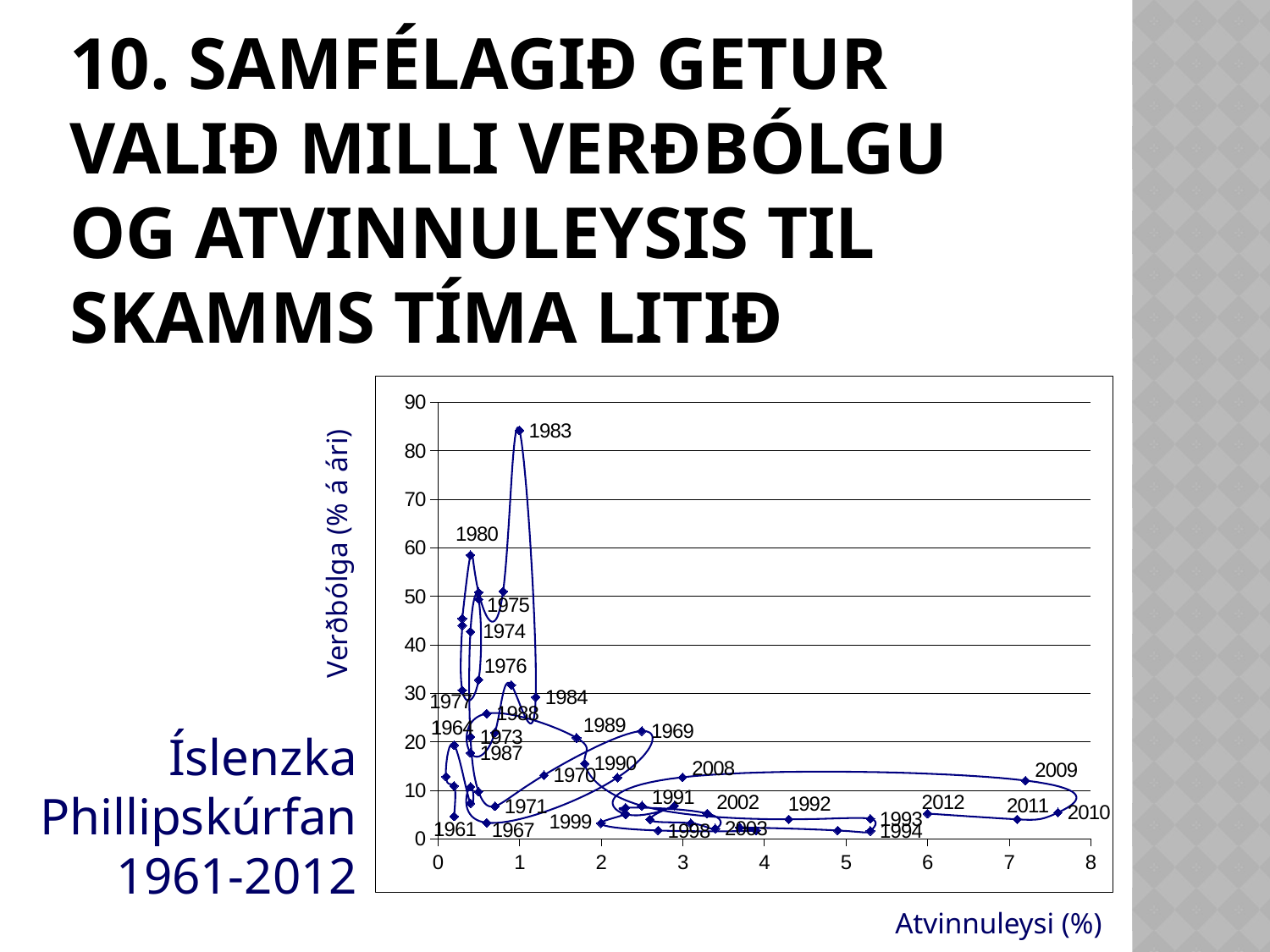
Which year has the highest inflation (Verðbólga) value on the chart? 1983 Is the unemployment value for 1983 greater or less than 2? less Is the unemployment value for 1994 greater or less than 4? greater What is the label of the horizontal axis of the chart? Atvinnuleysi (%) What kind of chart is shown on the slide? scatter chart Which year has the highest unemployment (Atvinnuleysi) value on the chart? 2010 Is the inflation value for 1983 greater or less than 80? greater Which year has the higher inflation value, 1983 or 1980? 1983 What is the label of the vertical axis of the chart? Verðbólga (% á ári)